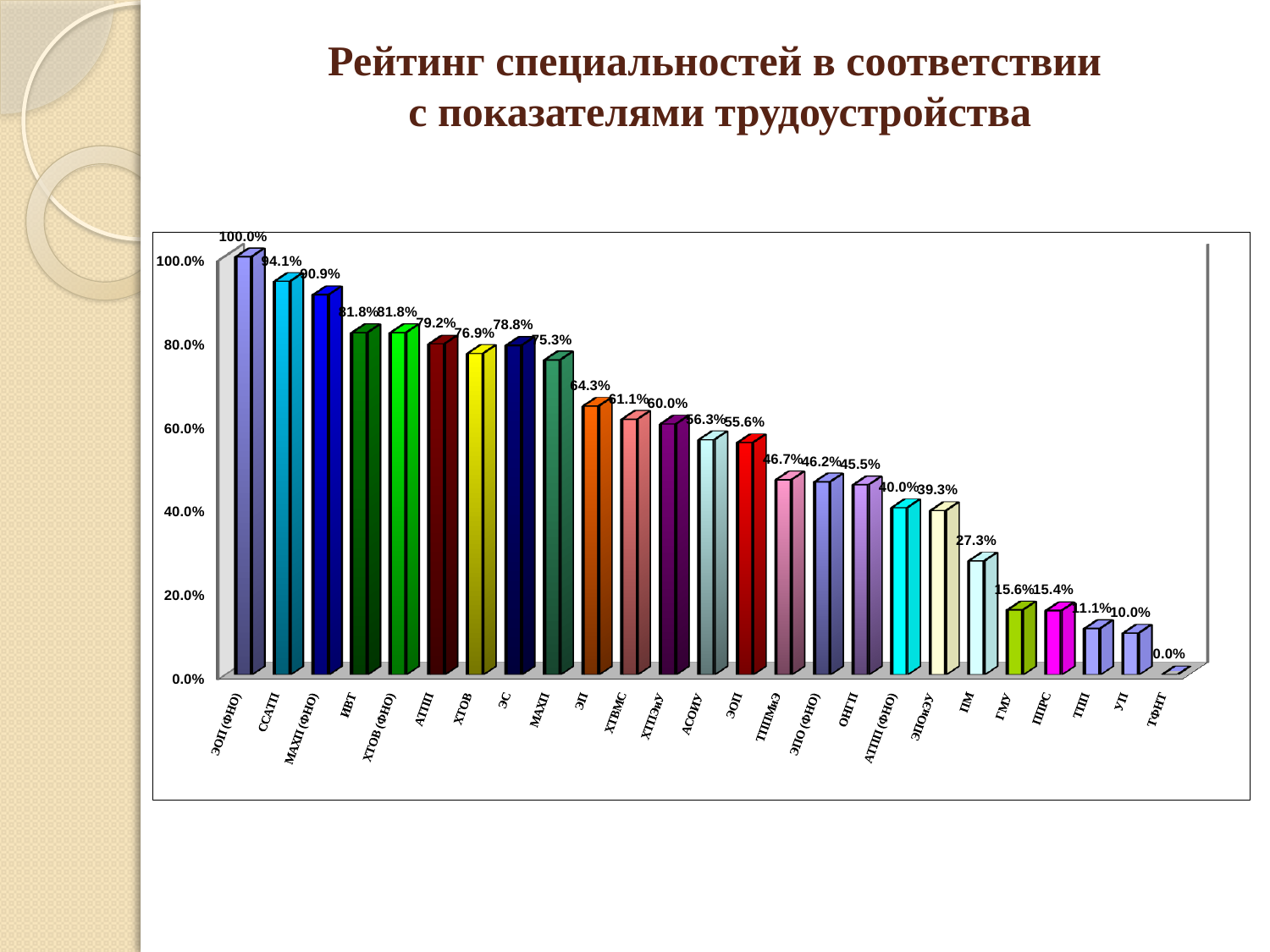
What is the value for ЭП? 64.3% How many categories are shown on the x axis? 25 Which category has the highest value? ЭОП (ФНО) What is the value for ССАТП? 94.1% Which is larger, the value for ХТОВ or the value for ЭС? ЭС What type of chart is shown on the slide? bar chart Which category has the lowest value? ТФНТ What is the value for ПМ? 27.3% Is the value for АСОИУ greater or less than 60.0%? less What is the value for ИВТ? 81.8% What is the difference between the values for ЭС and МАХП? 3.5% Do the values rise or fall from left to right along the x axis? fall